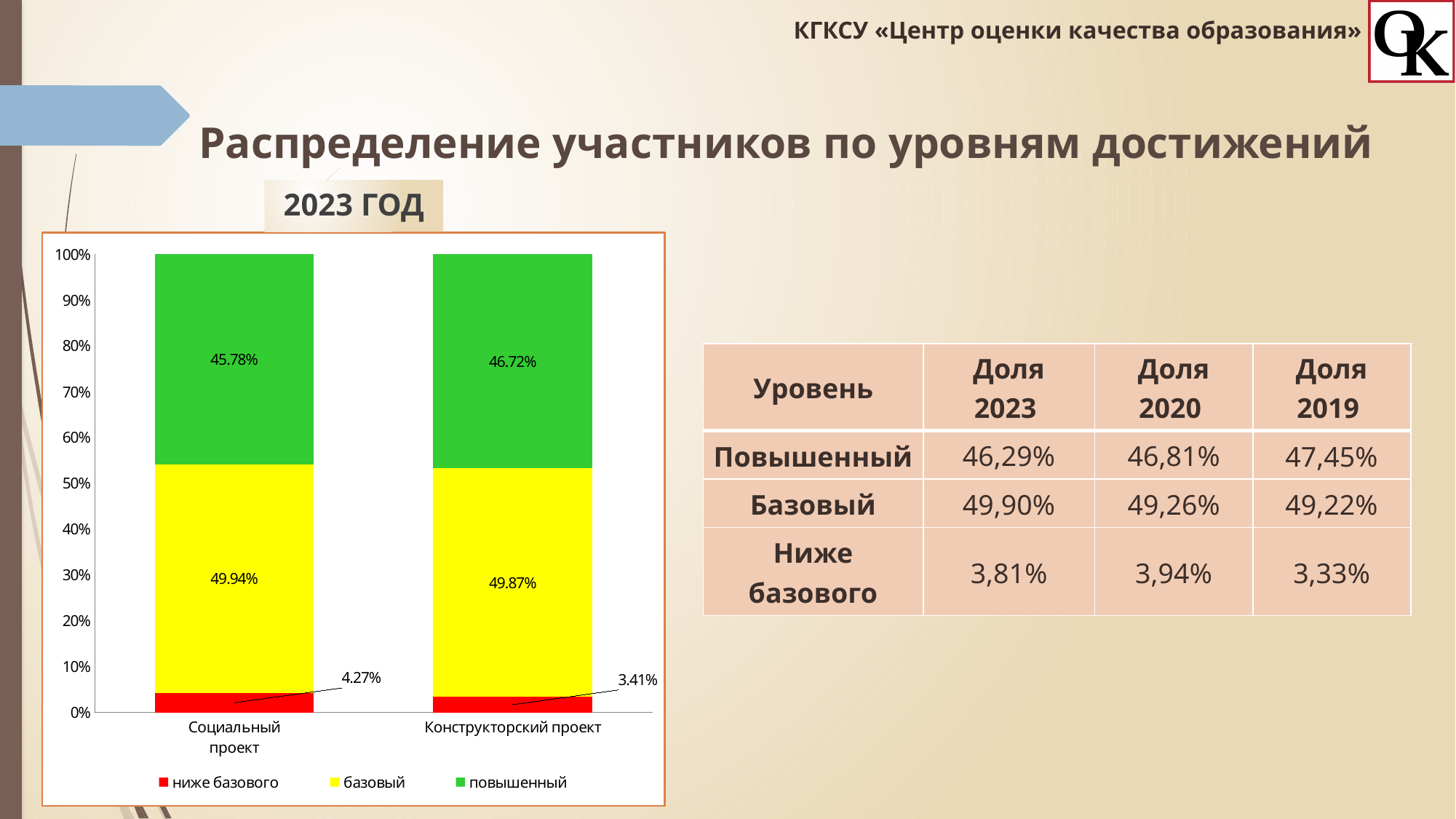
What is the difference between the 'ниже базового' values for 'Социальный проект' and 'Конструкторский проект'? 0.86% Which level has the smallest share for 'Конструкторский проект'? ниже базового What is the difference between the 'повышенный' values for 'Конструкторский проект' and 'Социальный проект'? 0.94% What is the value of the 'базовый' segment for 'Конструкторский проект'? 49.87% Which level has the largest share for 'Социальный проект'? базовый Which category has the larger 'повышенный' share, 'Социальный проект' or 'Конструкторский проект'? Конструкторский проект What is the value of the 'ниже базового' segment for 'Социальный проект'? 4.27% What is the value of the 'ниже базового' segment for 'Конструкторский проект'? 3.41% How many categories are shown on the x axis of the chart? 2 What kind of chart is shown on the slide? Stacked bar chart What is the value of the 'повышенный' segment for 'Социальный проект'? 45.78% How many series does the chart legend list? 3